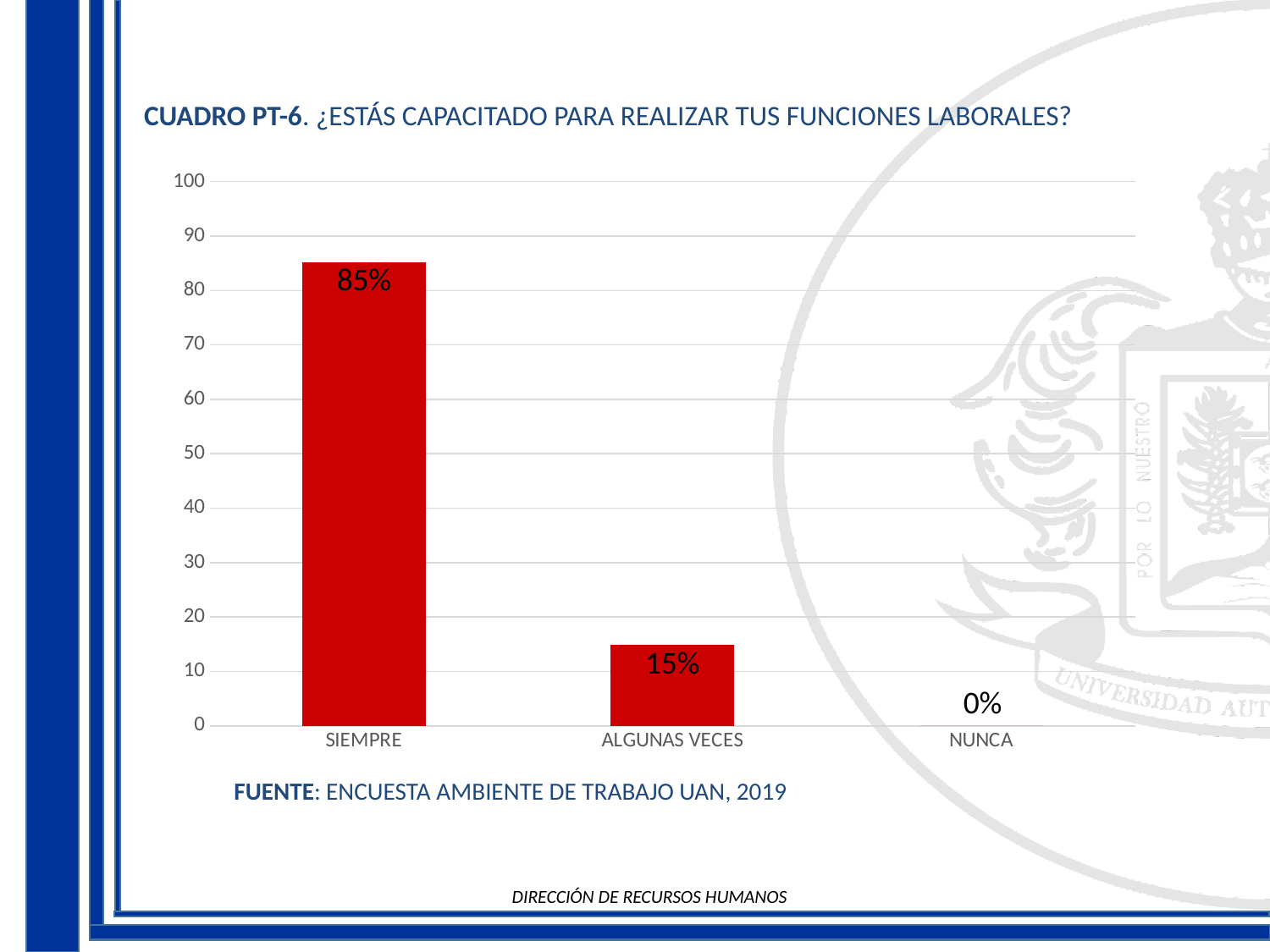
What is the value for NUNCA? 0% What kind of chart is shown on the slide? bar chart Is the value for SIEMPRE greater or less than 80? greater What is the value for ALGUNAS VECES? 15% Which is larger, the value for ALGUNAS VECES or the value for NUNCA? ALGUNAS VECES How many categories are shown on the x axis? 3 Which category has the highest value? SIEMPRE What source is cited below the chart? ENCUESTA AMBIENTE DE TRABAJO UAN, 2019 What is the difference between the values for SIEMPRE and ALGUNAS VECES? 70% What is the value for SIEMPRE? 85% Do the values rise or fall from SIEMPRE to NUNCA along the x axis? fall Which category has the lowest value? NUNCA